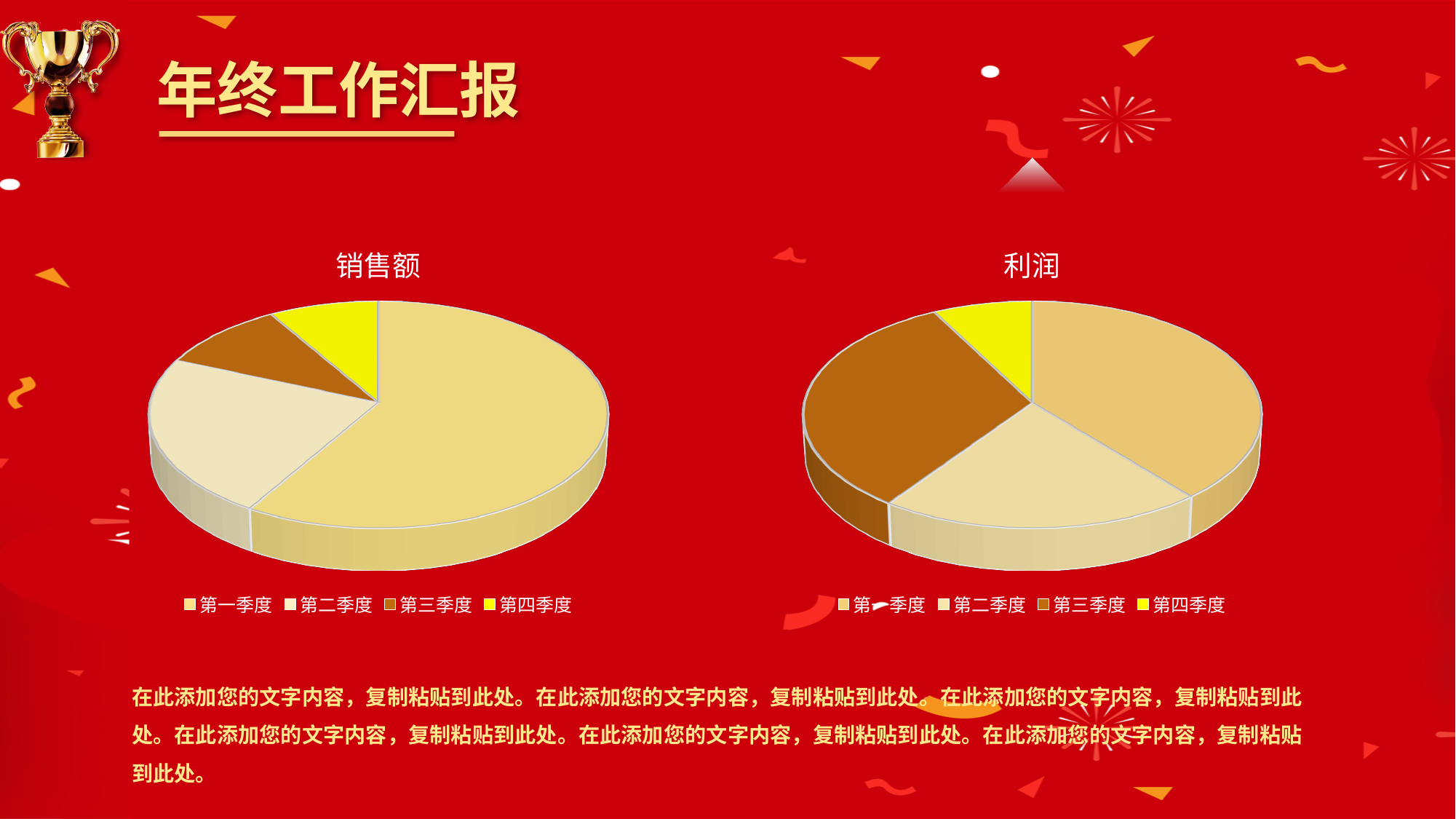
What kind of chart is the chart titled 销售额? pie chart In the 销售额 chart, which quarter has the smallest slice? 第四季度 In the 利润 chart, which is larger, the slice for 第一季度 or the slice for 第二季度? 第一季度 What is the title of the pie chart on the right side of the slide? 利润 In the 销售额 chart, how many slices does the pie have? 4 In the 利润 chart, which quarter has the smallest slice? 第四季度 In the 销售额 chart, which is larger, the slice for 第二季度 or the slice for 第三季度? 第二季度 What kind of chart is the chart titled 利润? pie chart In the 销售额 chart, which quarter has the largest slice? 第一季度 In the 利润 chart, how many categories does the legend list? 4 In the 销售额 chart, which quarter is shown in yellow? 第四季度 In the 利润 chart, which is larger, the slice for 第二季度 or the slice for 第四季度? 第二季度